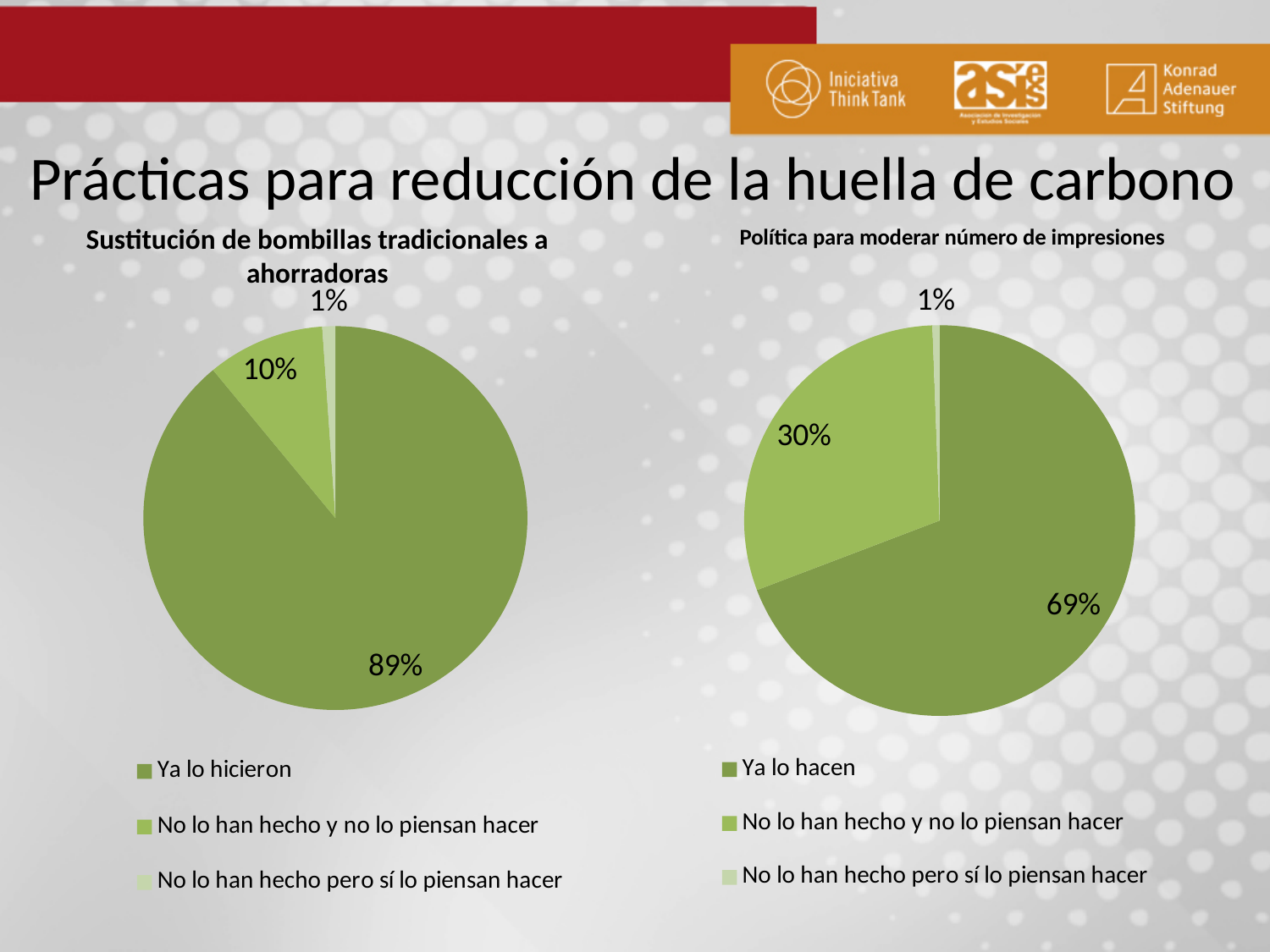
In the chart titled "Política para moderar número de impresiones", what is the difference in percentage points between "Ya lo hacen" and "No lo han hecho y no lo piensan hacer"? 39 What type of chart is used on the left side of the slide? Pie chart In the chart titled "Sustitución de bombillas tradicionales a ahorradoras", what share of the pie is "Ya lo hicieron"? 89% In the chart titled "Política para moderar número de impresiones", what percentage is shown for "No lo han hecho y no lo piensan hacer"? 30% In the chart titled "Política para moderar número de impresiones", what share of the pie is "Ya lo hacen"? 69% In the chart titled "Sustitución de bombillas tradicionales a ahorradoras", what percentage is shown for "No lo han hecho y no lo piensan hacer"? 10% In the chart titled "Sustitución de bombillas tradicionales a ahorradoras", what is the difference in percentage points between "Ya lo hicieron" and "No lo han hecho y no lo piensan hacer"? 79 In the chart titled "Política para moderar número de impresiones", which category has the smallest slice? No lo han hecho pero sí lo piensan hacer In the chart titled "Sustitución de bombillas tradicionales a ahorradoras", which category has the largest slice? Ya lo hicieron In the chart titled "Sustitución de bombillas tradicionales a ahorradoras", what percentage is shown for "No lo han hecho pero sí lo piensan hacer"? 1% Which chart has the larger share for "No lo han hecho y no lo piensan hacer", the left chart or the right chart? The right chart How many categories does the legend of the chart titled "Política para moderar número de impresiones" list? 3